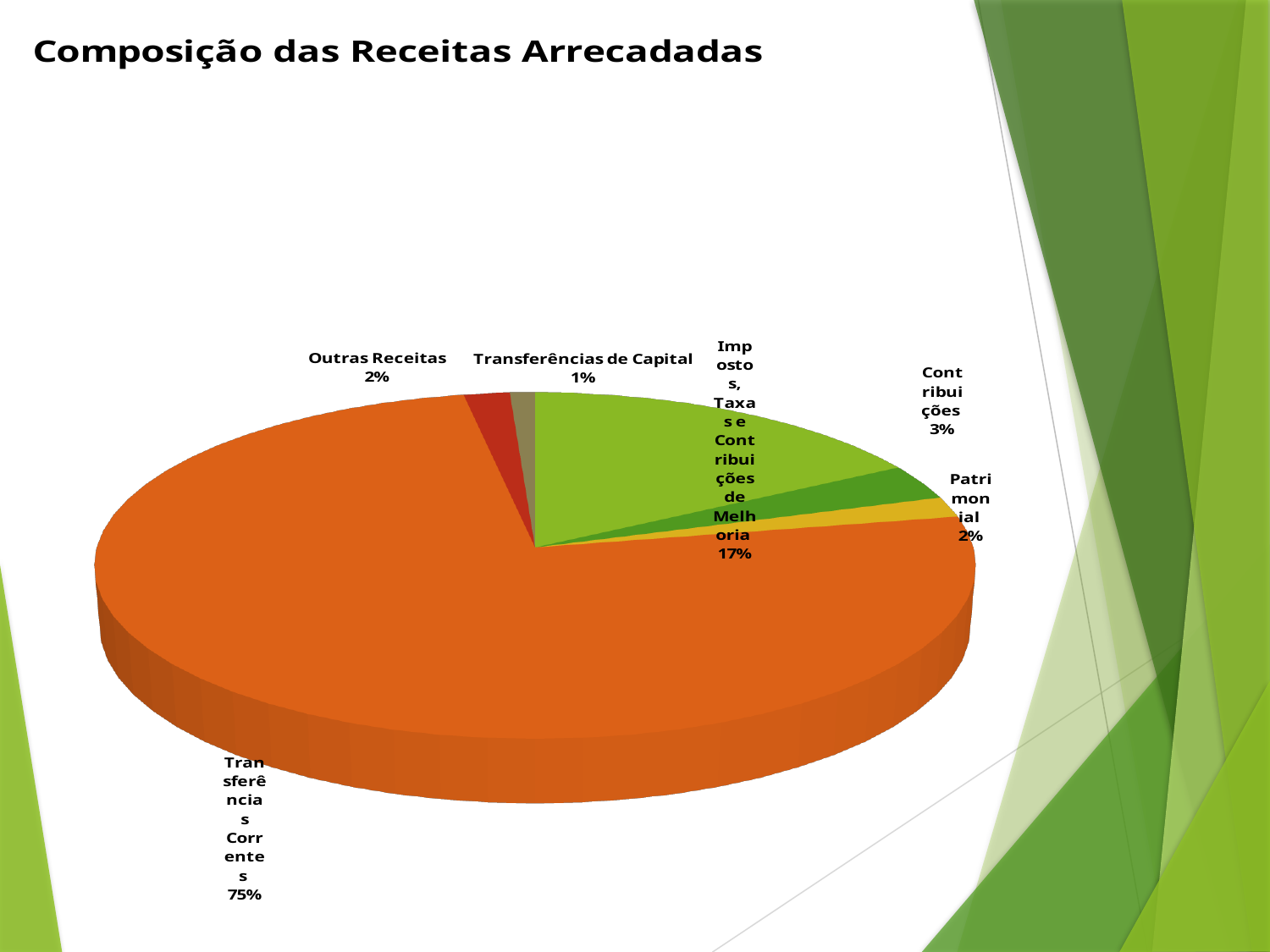
What share of the pie does Impostos, Taxas e Contribuições de Melhoria represent? 17% What is the value shown for Transferências de Capital? 1% What kind of chart is shown on the slide? Pie chart Which category has the smallest slice of the pie? Transferências de Capital What is the title of the chart? Composição das Receitas Arrecadadas What is the value shown for Patrimonial? 2% Which category has the largest slice of the pie? Transferências Correntes What is the value shown for Contribuições? 3% What share of the pie does Transferências Correntes represent? 75% Which is larger, the share for Contribuições or the share for Outras Receitas? Contribuições What is the difference in percentage points between Transferências Correntes and Impostos, Taxas e Contribuições de Melhoria? 58 percentage points How many slices does the pie chart have? 6